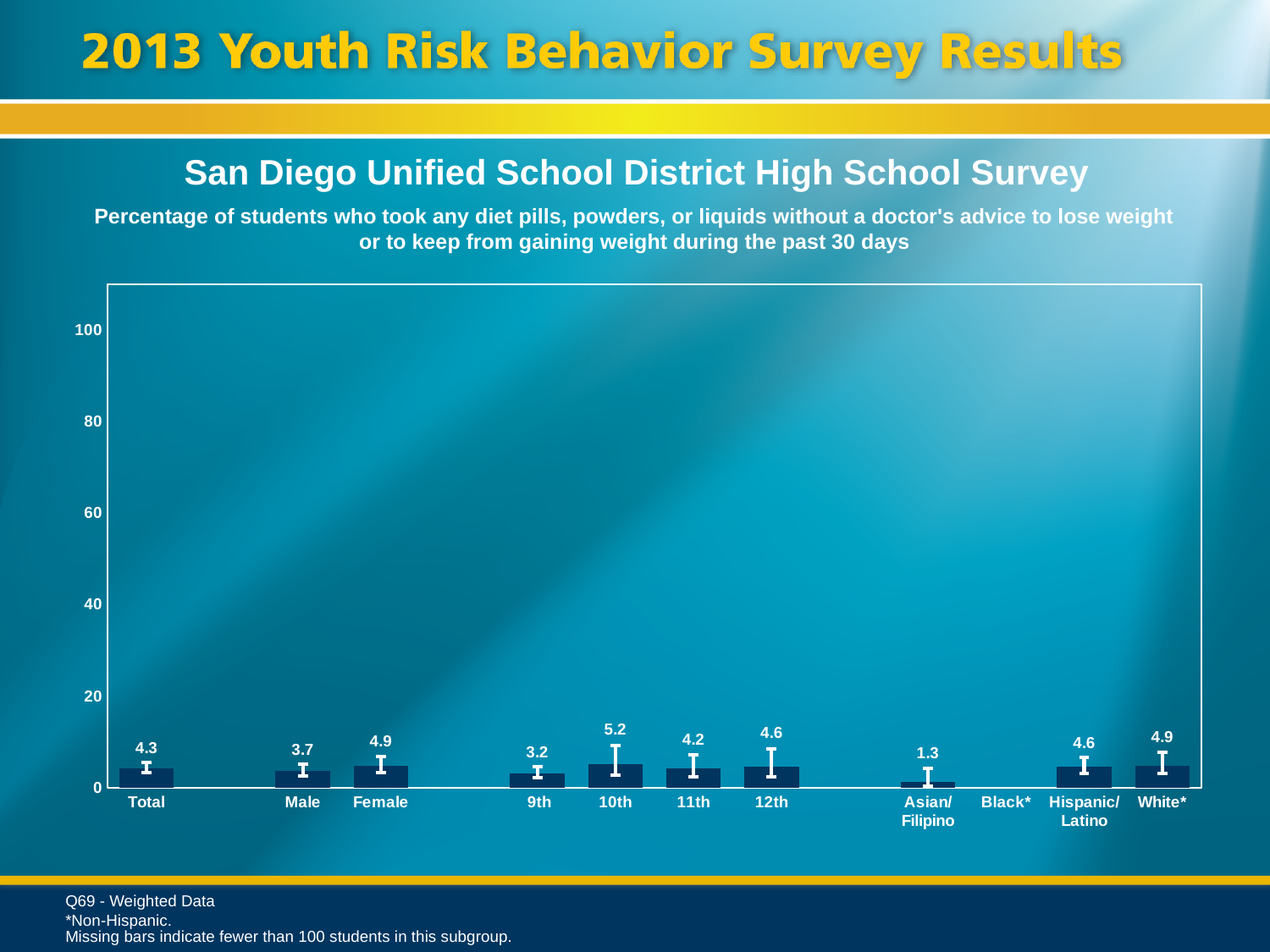
Which category with a plotted bar has the lowest value? Asian/Filipino What is the difference between the Female and Male values? 1.2 What is the value for 10th grade? 5.2 What kind of chart is shown? bar chart What is the value for Female? 4.9 What is the value for Asian/Filipino? 1.3 Is the value for Hispanic/Latino greater or less than 20? less Which is larger, the value for 9th grade or 12th grade? 12th Which category has the highest value? 10th How many categories are labeled on the x axis? 11 What is the value for Total? 4.3 Which category has no bar plotted? Black*